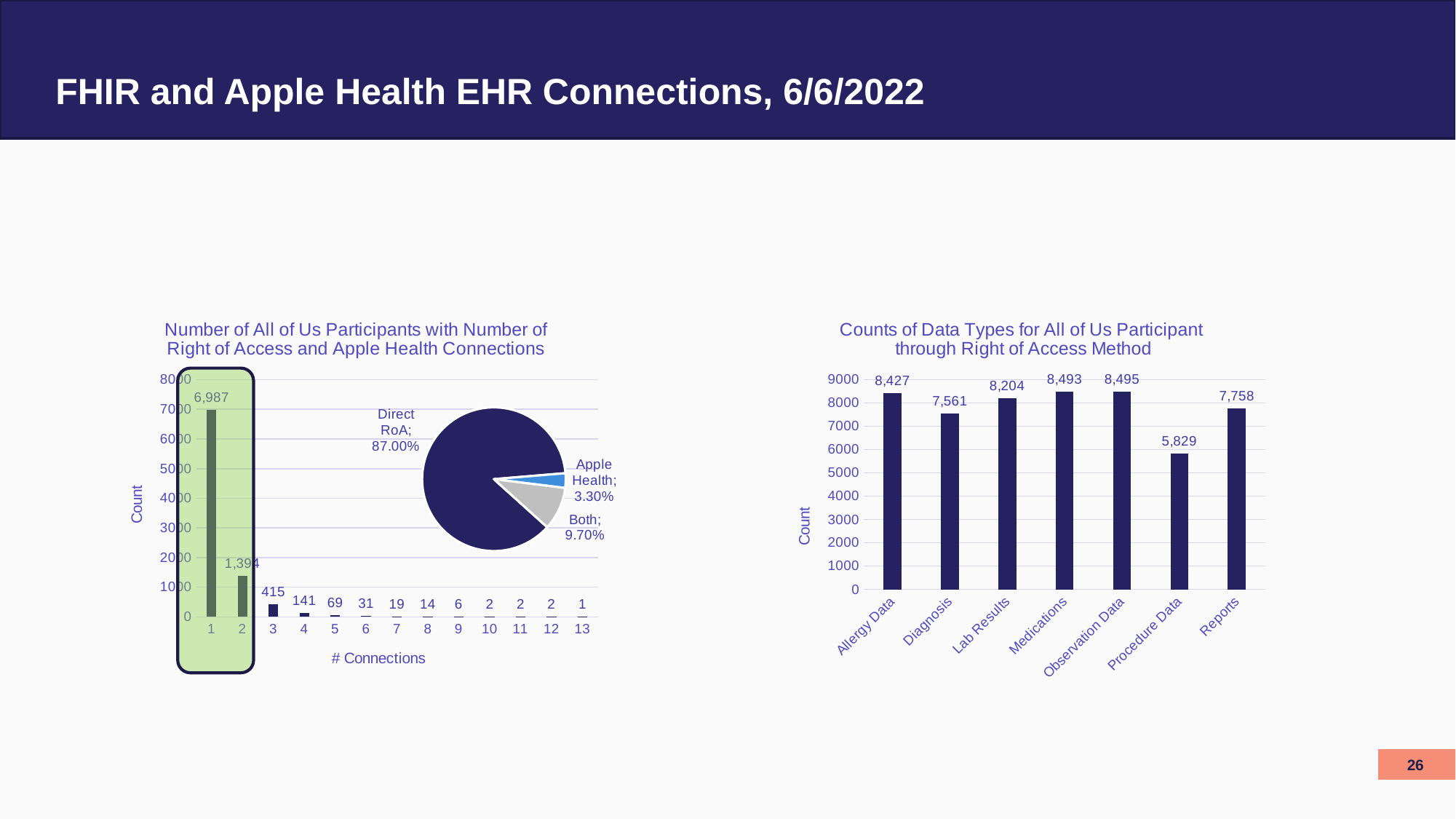
In the chart titled "Counts of Data Types for All of Us Participant through Right of Access Method", what is the count for Procedure Data? 5,829 In the chart titled "Counts of Data Types for All of Us Participant through Right of Access Method", what is the difference between the counts for Medications and Diagnosis? 932 In the chart titled "Number of All of Us Participants with Number of Right of Access and Apple Health Connections", what is the count for 3 connections? 415 In the chart titled "Number of All of Us Participants with Number of Right of Access and Apple Health Connections", how many connection categories are shown on the x axis? 13 What kind of chart is the one titled "Counts of Data Types for All of Us Participant through Right of Access Method"? bar chart In the chart titled "Number of All of Us Participants with Number of Right of Access and Apple Health Connections", what is the count for 1 connection? 6,987 In the chart titled "Number of All of Us Participants with Number of Right of Access and Apple Health Connections", do the counts rise or fall as the number of connections increases? fall In the pie chart on the left side of the slide, which slice is the smallest? Apple Health In the chart titled "Number of All of Us Participants with Number of Right of Access and Apple Health Connections", what is the difference between the counts for 1 connection and 2 connections? 5,593 In the pie chart on the left side of the slide, what share is labelled for Apple Health? 3.30% In the pie chart on the left side of the slide, what share is labelled for Direct RoA? 87.00% In the chart titled "Counts of Data Types for All of Us Participant through Right of Access Method", which data type has the lowest count? Procedure Data